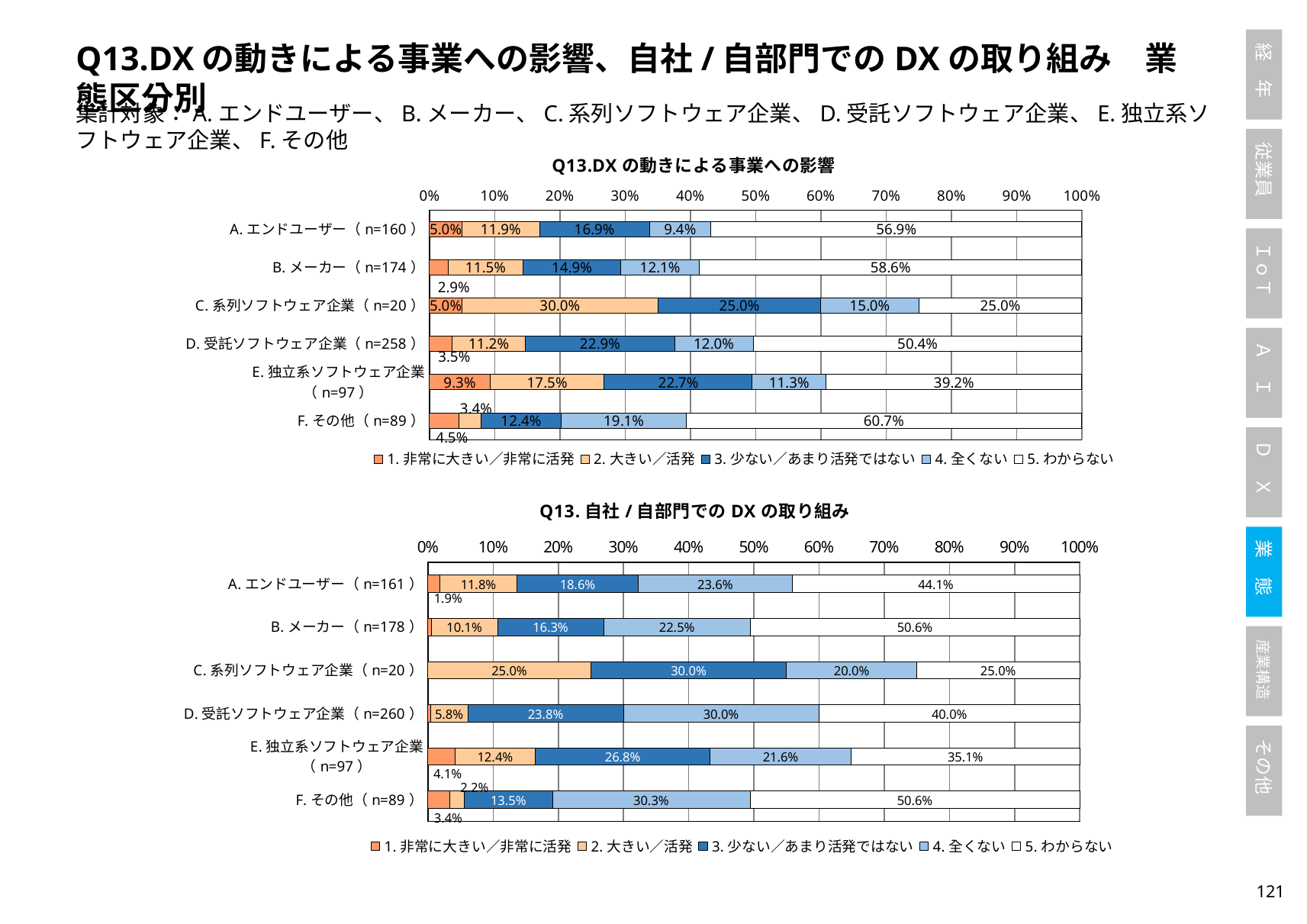
In the top chart (Q13.DXの動きによる事業への影響), what is the value of 5. わからない for A. エンドユーザー (n=160)? 56.9% In the top chart (Q13.DXの動きによる事業への影響), which category has the lowest value for 5. わからない? C. 系列ソフトウェア企業 (n=20) In the bottom chart (Q13. 自社/自部門でのDXの取り組み), what is the value of 3. 少ない／あまり活発ではない for E. 独立系ソフトウェア企業 (n=97)? 26.8% In the bottom chart (Q13. 自社/自部門でのDXの取り組み), what is the value of 4. 全くない for F. その他 (n=89)? 30.3% In the bottom chart (Q13. 自社/自部門でのDXの取り組み), which category has the highest value for 3. 少ない／あまり活発ではない? C. 系列ソフトウェア企業 (n=20) In the top chart (Q13.DXの動きによる事業への影響), what is the value of 2. 大きい／活発 for C. 系列ソフトウェア企業 (n=20)? 30.0% How many categories are shown on the y axis of the bottom chart (Q13. 自社/自部門でのDXの取り組み)? 6 In the top chart (Q13.DXの動きによる事業への影響), which is larger: the 1. 非常に大きい／非常に活発 value for E. 独立系ソフトウェア企業 or for A. エンドユーザー? E. 独立系ソフトウェア企業 In the top chart (Q13.DXの動きによる事業への影響), what is the difference between the 3. 少ない／あまり活発ではない values for D. 受託ソフトウェア企業 and B. メーカー? 8.0% How many series does the legend of the top chart (Q13.DXの動きによる事業への影響) list? 5 In the bottom chart (Q13. 自社/自部門でのDXの取り組み), what is the difference between the 5. わからない values for B. メーカー and D. 受託ソフトウェア企業? 10.6% In the top chart (Q13.DXの動きによる事業への影響), which category has the highest value for 5. わからない? F. その他 (n=89)